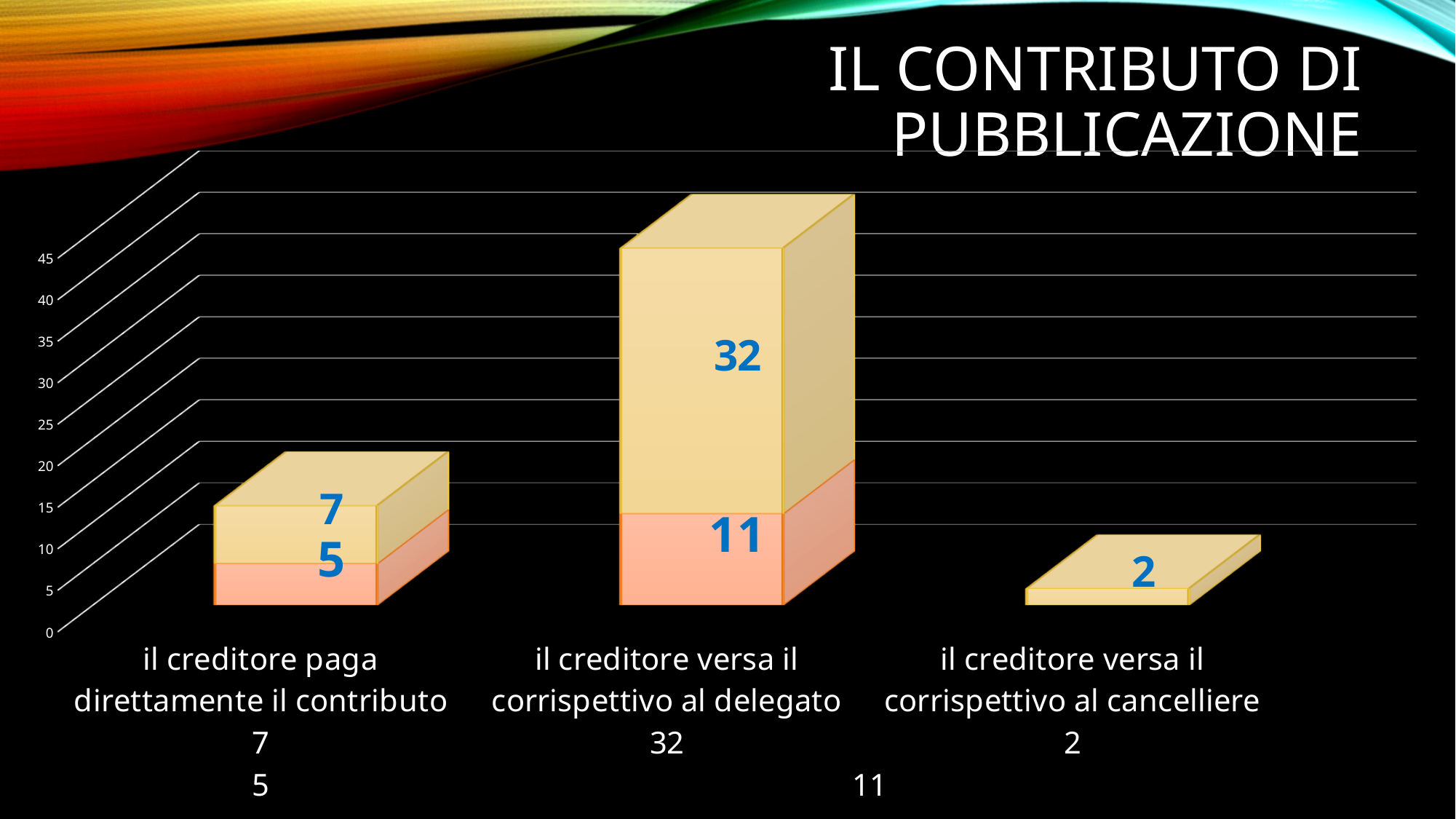
What is the title of the slide containing the chart? IL CONTRIBUTO DI PUBBLICAZIONE What is the value of the pink segment for 'il creditore paga direttamente il contributo'? 5 What type of chart is shown on the slide? bar chart What is the total of the stacked bar for 'il creditore versa il corrispettivo al delegato'? 43 What is the value shown for 'il creditore versa il corrispettivo al cancelliere'? 2 What is the value of the yellow segment for 'il creditore paga direttamente il contributo'? 7 Which category has the shortest bar? il creditore versa il corrispettivo al cancelliere How many categories are shown on the x axis of the chart? 3 What is the value of the yellow segment for 'il creditore versa il corrispettivo al delegato'? 32 Which category has the tallest stacked bar? il creditore versa il corrispettivo al delegato What is the value of the pink segment for 'il creditore versa il corrispettivo al delegato'? 11 What is the difference between the yellow segment values for 'il creditore versa il corrispettivo al delegato' and 'il creditore paga direttamente il contributo'? 25